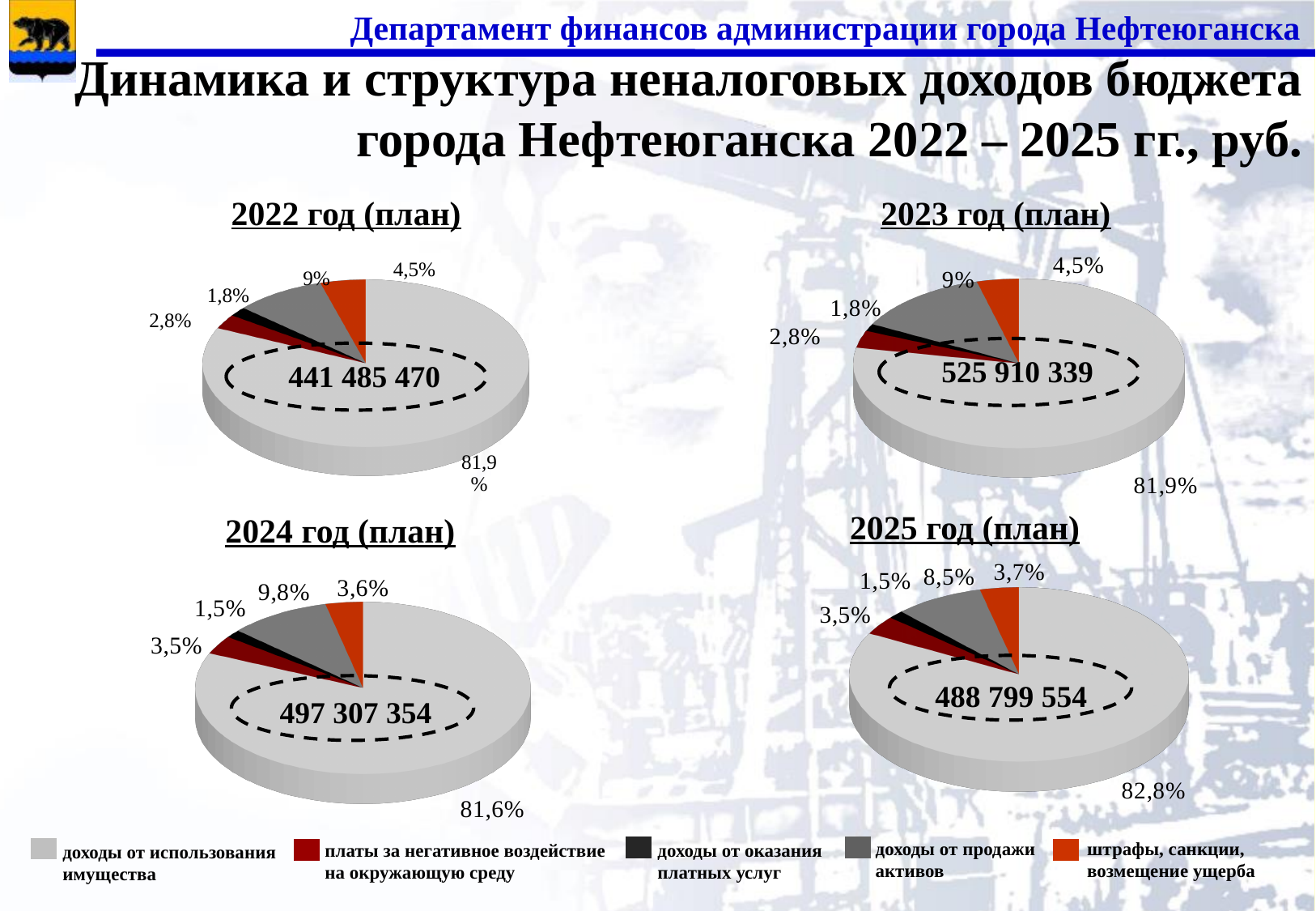
In the 2025 год (план) chart, what total value is printed in the centre of the pie? 488 799 554 In the 2022 год (план) chart, what total value is printed in the centre of the pie? 441 485 470 In the 2024 год (план) chart, what total value is printed in the centre of the pie? 497 307 354 In the 2025 год (план) chart, what is the difference between the share of доходы от продажи активов and the share of штрафы, санкции, возмещение ущерба? 4,8% What kind of charts are shown on the slide? Pie charts How many categories does the legend at the bottom of the slide list? 5 In the 2022 год (план) chart, which category has the smallest share? доходы от оказания платных услуг In the 2025 год (план) chart, what share does доходы от использования имущества have? 82,8% How many pie charts are on the slide? 4 In the 2023 год (план) chart, what total value is printed in the centre of the pie? 525 910 339 Which year's chart shows the largest total in its centre? 2023 год (план) In the 2024 год (план) chart, what share does доходы от продажи активов have? 9,8%